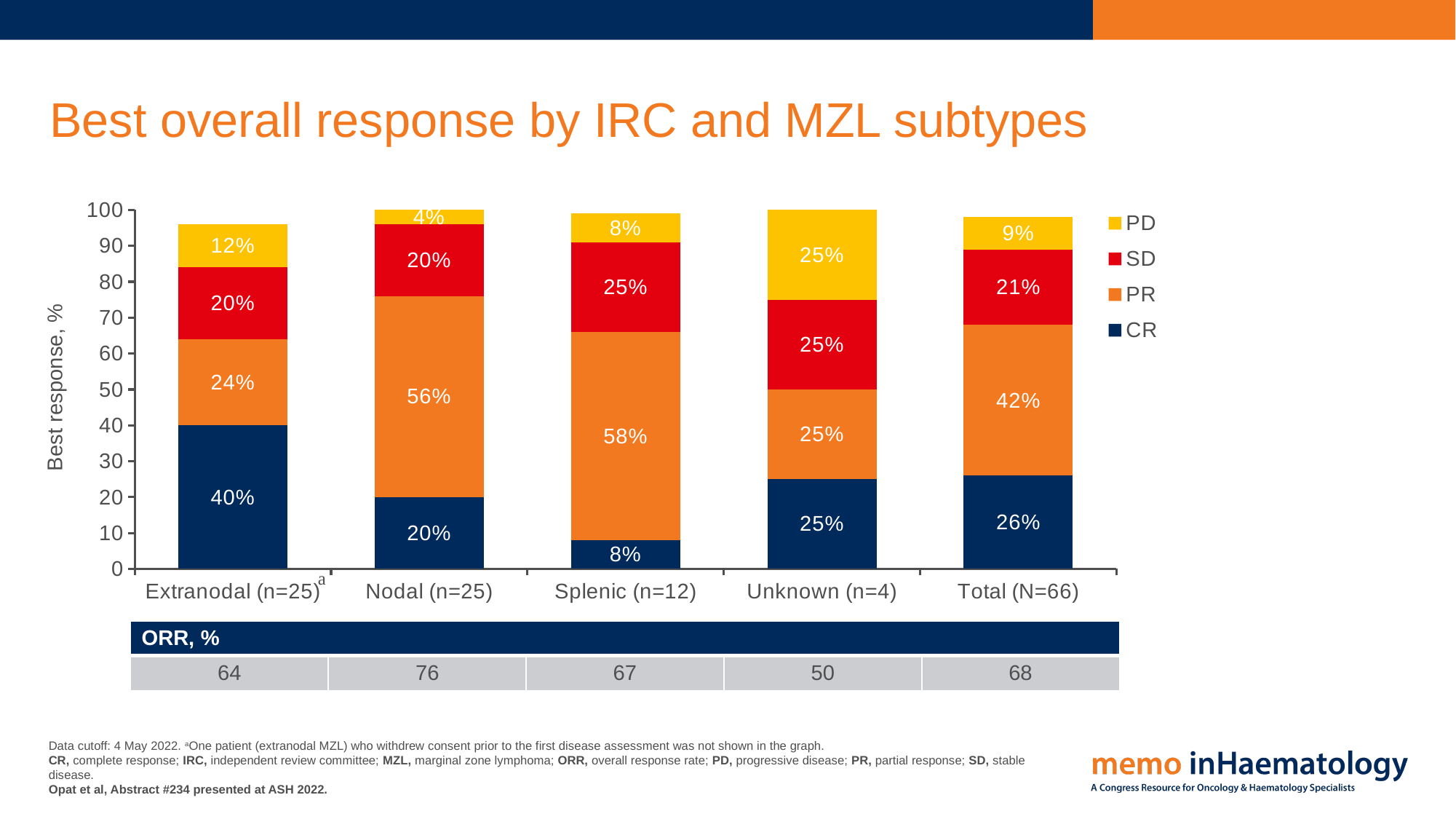
What is the CR value for Extranodal (n=25)? 40% What is the total of the stacked bar for Extranodal (n=25), summing the printed labels? 96% What kind of chart is shown on the slide? Stacked bar chart What is the PR value for Splenic (n=12)? 58% Which category has the highest CR value? Extranodal (n=25) Which category has the lowest CR value? Splenic (n=12) How many series does the legend list? 4 What is the difference between the PR value for Nodal (n=25) and the PR value for Extranodal (n=25)? 32% What is the PD value for Unknown (n=4)? 25% Which is larger, the SD value for Splenic (n=12) or the SD value for Nodal (n=25)? Splenic (n=12) How many categories are shown on the x axis of the chart? 5 What is the title of the chart? Best overall response by IRC and MZL subtypes